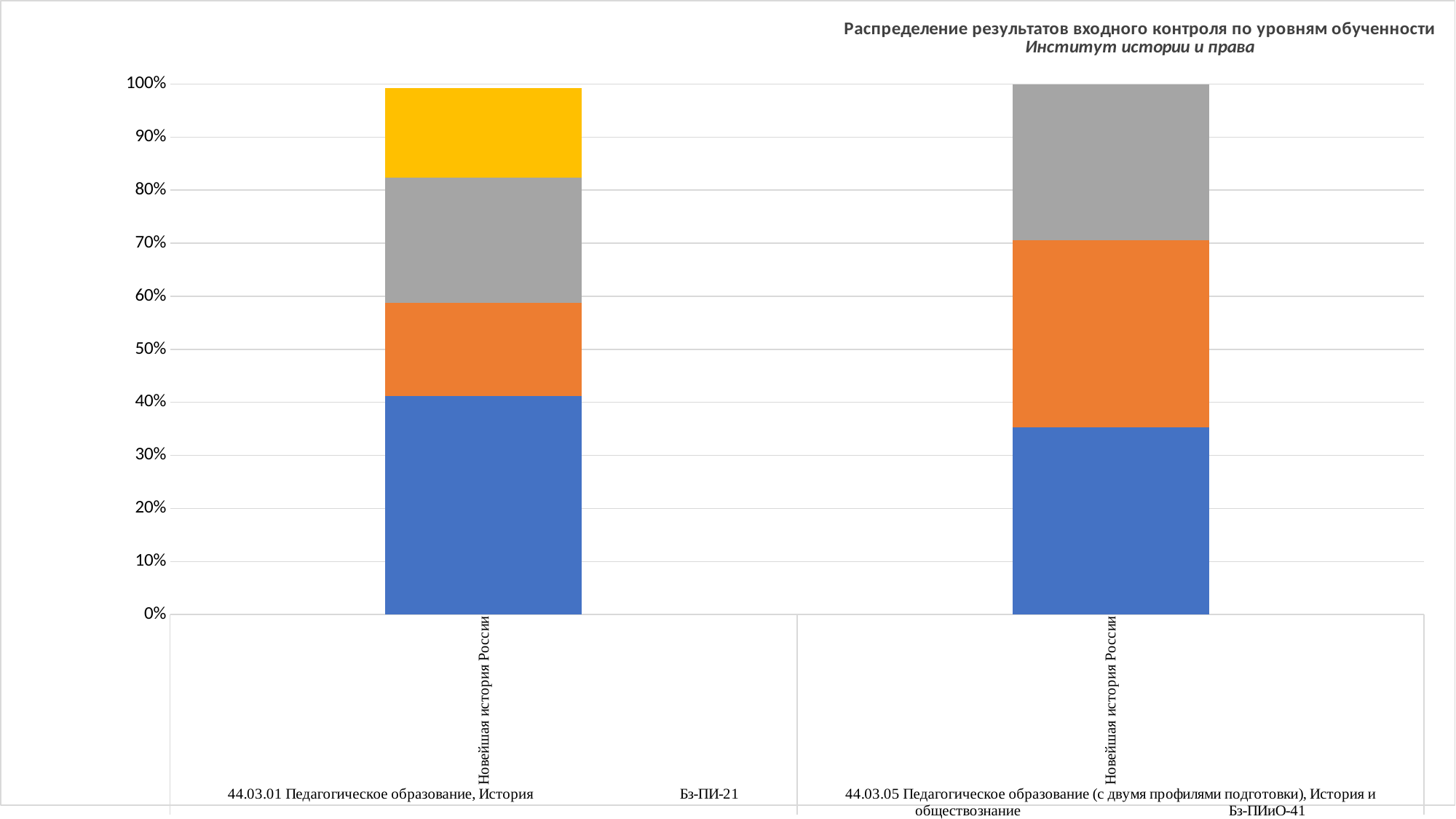
Which institute is named in the chart subtitle? Институт истории и права How many bars (groups) are plotted in the chart? 2 How many coloured segments make up the bar for group Бз-ПИ-21? 4 What is the title of the chart? Распределение результатов входного контроля по уровням обученности Which group has the larger orange segment, Бз-ПИ-21 or Бз-ПИиО-41? Бз-ПИиО-41 Is the top of the orange segment for group Бз-ПИ-21 greater or less than 50%? greater Which group has the larger blue segment, Бз-ПИ-21 or Бз-ПИиО-41? Бз-ПИ-21 Is the top of the orange segment for group Бз-ПИиО-41 greater or less than 60%? greater Is the blue segment for group Бз-ПИ-21 greater or less than 30%? greater What kind of chart is shown on the slide? Stacked bar chart How many coloured segments make up the bar for group Бз-ПИиО-41? 3